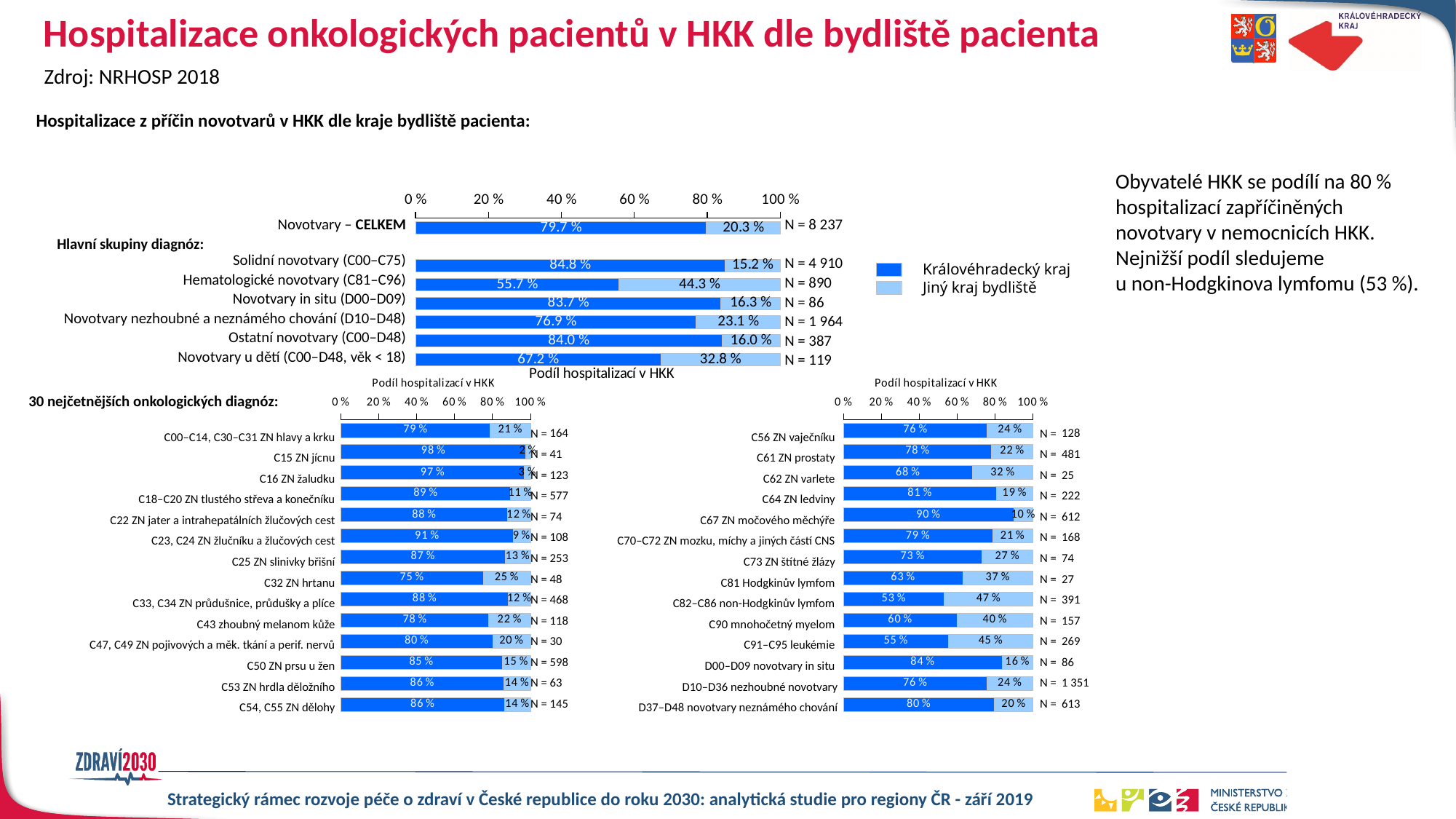
In the top chart (Hlavní skupiny diagnóz), which diagnosis group has the highest Královéhradecký kraj share? Solidní novotvary (C00–C75) In the bottom-right chart (30 nejčetnějších onkologických diagnóz), which diagnosis has the lowest Královéhradecký kraj share? C82–C86 non-Hodgkinův lymfom What kind of chart is the top chart (Hlavní skupiny diagnóz)? Stacked bar chart In the bottom-left chart (30 nejčetnějších onkologických diagnóz), what is the Královéhradecký kraj share for C15 ZN jícnu? 98 % In the top chart (Hlavní skupiny diagnóz), what is the Královéhradecký kraj share for Hematologické novotvary (C81–C96)? 55.7 % How many bars (diagnosis rows) does the top chart (Hlavní skupiny diagnóz) show, including Novotvary – CELKEM? 7 In the bottom-left chart (30 nejčetnějších onkologických diagnóz), which diagnosis has the highest Královéhradecký kraj share? C15 ZN jícnu In the top chart (Hlavní skupiny diagnóz), which diagnosis group has the lowest Královéhradecký kraj share? Hematologické novotvary (C81–C96) In the top chart (Hlavní skupiny diagnóz), what is the Jiný kraj bydliště share for Novotvary u dětí (C00–D48, věk < 18)? 32.8 % How many series does the legend of the top chart list? 2 In the bottom-right chart (30 nejčetnějších onkologických diagnóz), what is the N value for D10–D36 nezhoubné novotvary? N = 1 351 In the top chart (Hlavní skupiny diagnóz), what is the difference between the Královéhradecký kraj shares for Solidní novotvary (C00–C75) and Hematologické novotvary (C81–C96)? 29.1 %